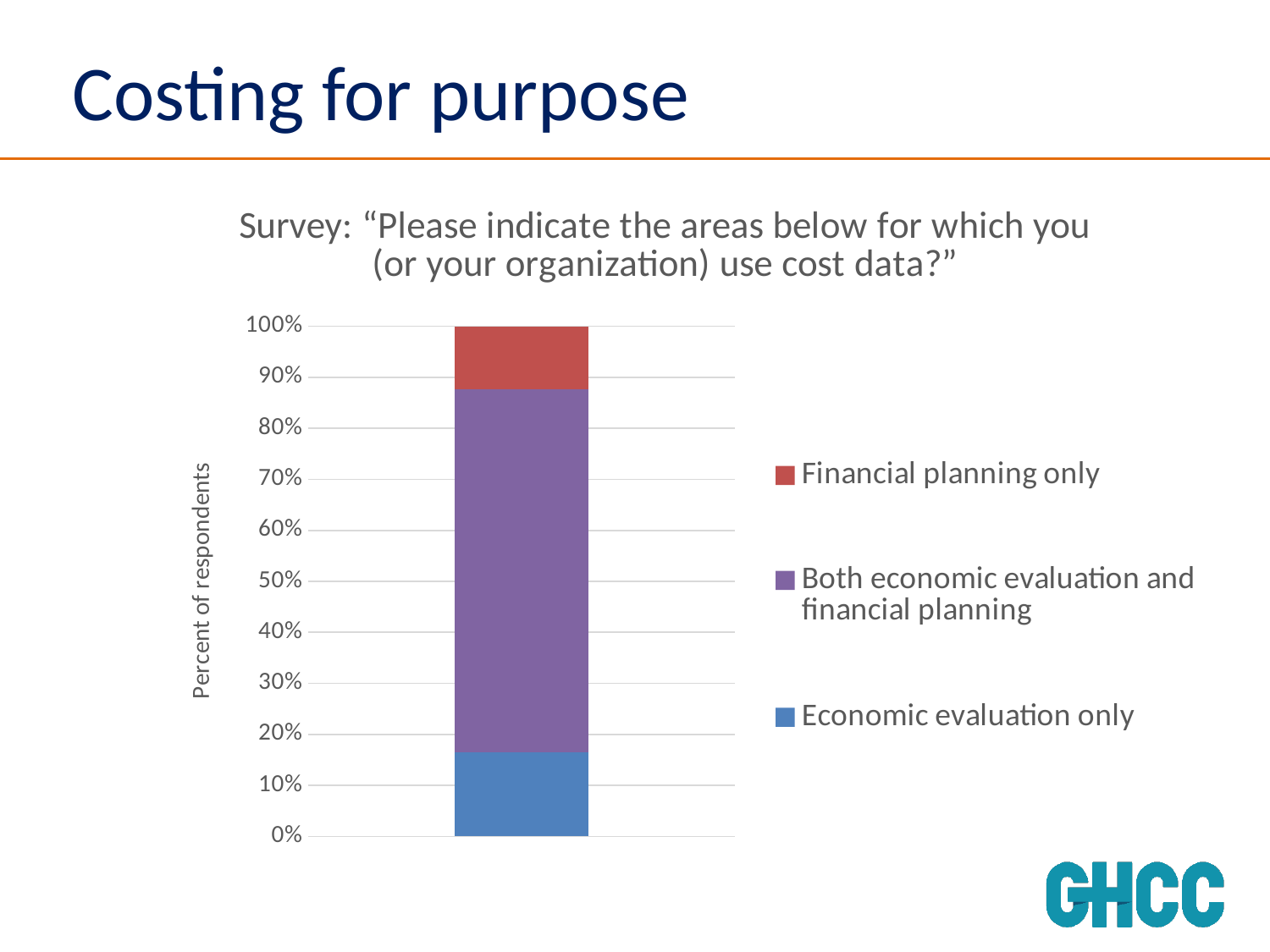
Is the value for Financial planning only greater or less than 20%? less How many bars are plotted in the chart? 1 Which series is shown in blue in the legend? Economic evaluation only Which series makes up the largest segment of the bar? Both economic evaluation and financial planning How many series does the legend list? 3 Which is larger: the segment for Both economic evaluation and financial planning or the segment for Economic evaluation only? Both economic evaluation and financial planning Is the value for Economic evaluation only greater or less than 20%? less What kind of chart is shown on the slide? stacked bar chart What is the total height of the stacked bar? 100% What is the label on the vertical axis? Percent of respondents Is the value for Economic evaluation only greater or less than 10%? greater